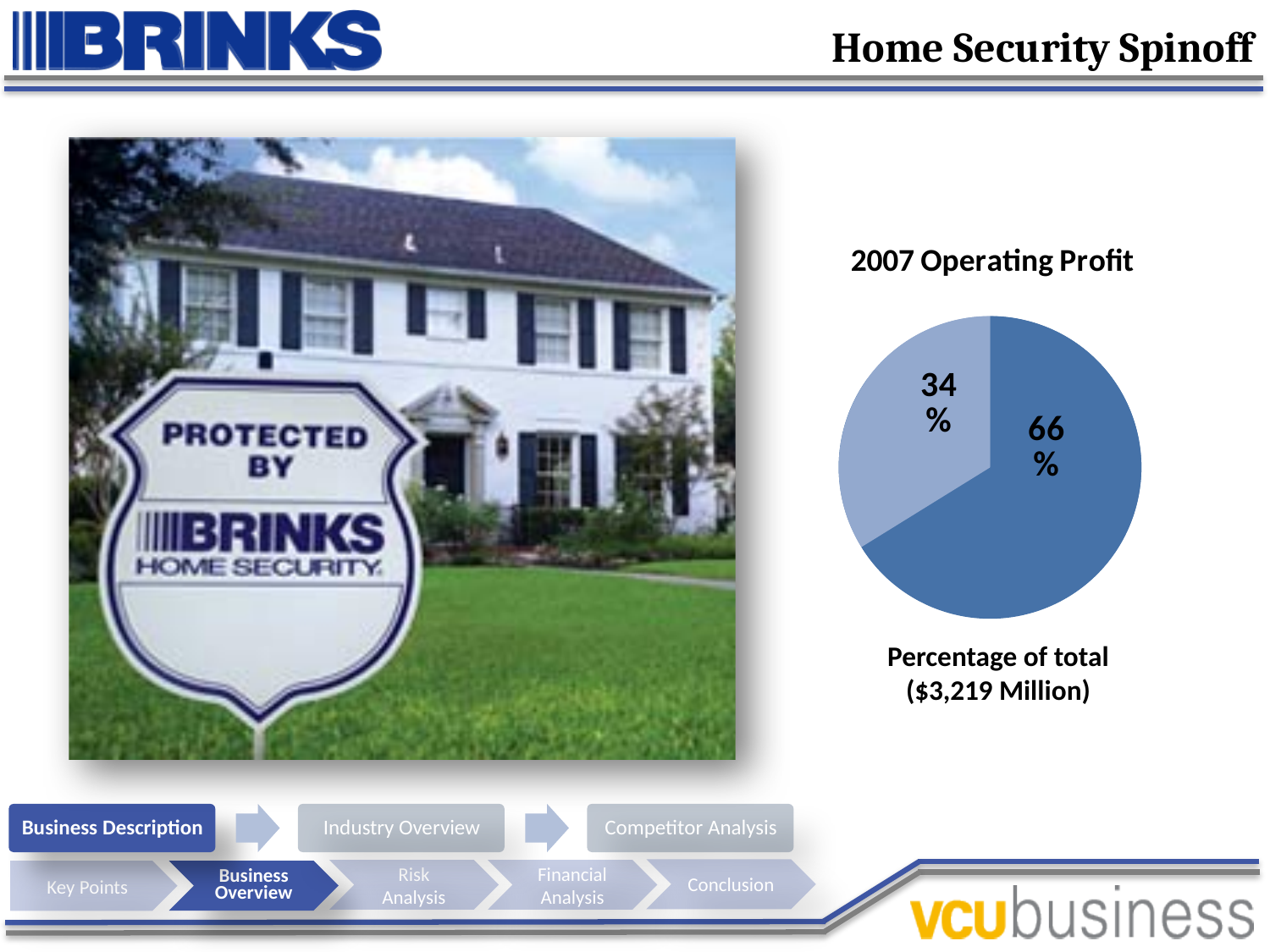
How many slices does the pie chart have? 2 What percentage is shown on the dark blue slice of the pie chart? 66% Is the share of the light blue slice greater or less than 50%? less What is the difference in percentage points between the two slices of the pie chart? 32 What kind of chart is shown on the slide? pie chart What total dollar amount does the pie chart say the percentages are based on? $3,219 Million What percentage is shown on the smaller slice of the pie chart? 34% Which slice of the pie chart is larger, the dark blue one or the light blue one? dark blue What percentage is shown on the larger slice of the pie chart? 66% What is the combined percentage of the two slices in the pie chart? 100% What percentage is shown on the light blue slice of the pie chart? 34% What is the title of the chart on the slide? 2007 Operating Profit